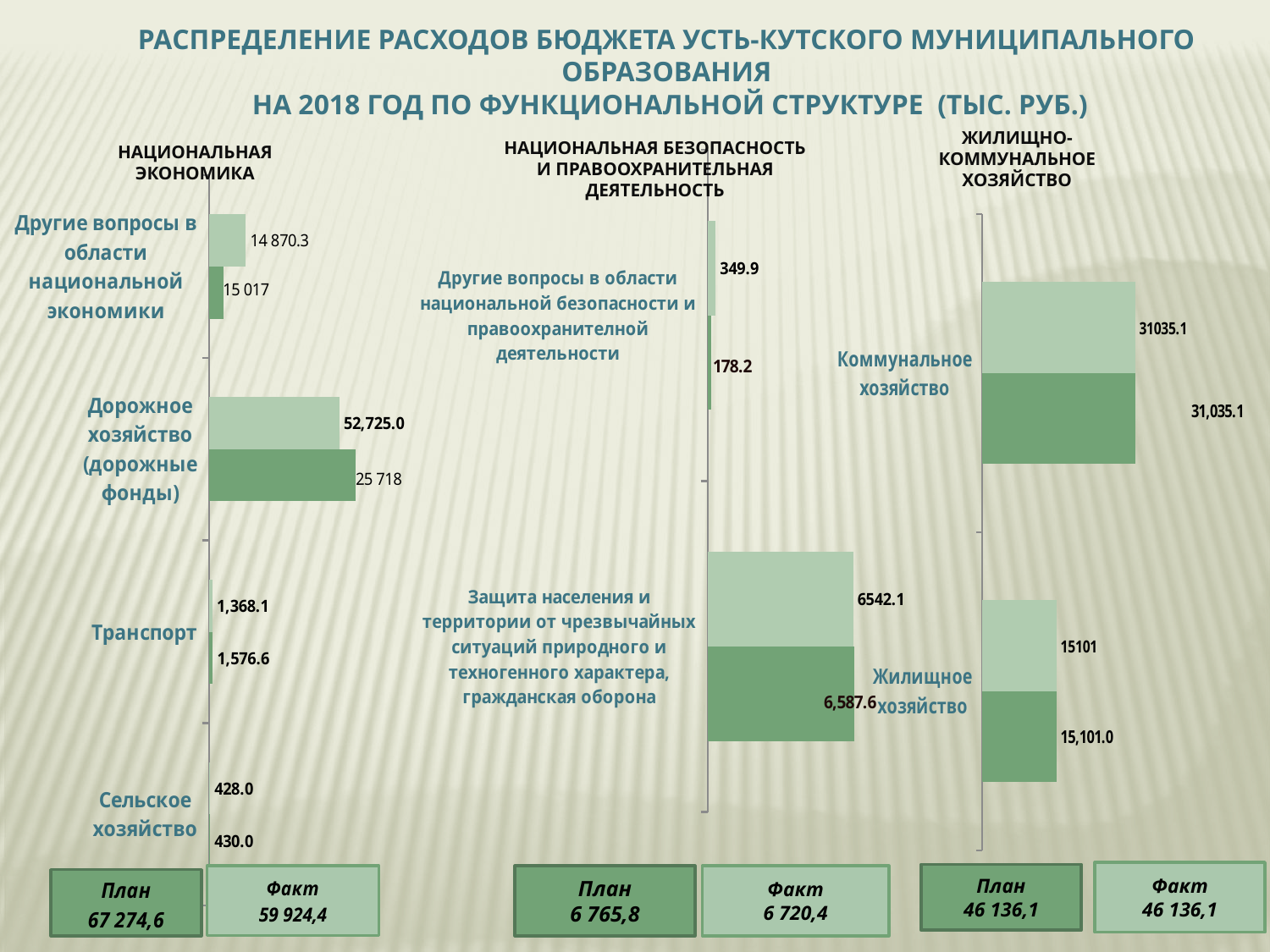
What kind of chart is used on the slide for the 'Национальная экономика' section? bar chart In the 'Национальная экономика' chart, what is the Факт value for 'Дорожное хозяйство (дорожные фонды)'? 52,725.0 In the 'Национальная экономика' chart, which category has the lowest План value? Сельское хозяйство In the 'Национальная экономика' chart, what is the План value for 'Дорожное хозяйство (дорожные фонды)'? 25 718 In the 'Жилищно-коммунальное хозяйство' chart, what is the План value for 'Жилищное хозяйство'? 15,101.0 In the 'Жилищно-коммунальное хозяйство' chart, which category has the larger Факт value, 'Коммунальное хозяйство' or 'Жилищное хозяйство'? Коммунальное хозяйство In the 'Национальная безопасность и правоохранительная деятельность' chart, what is the План value for 'Защита населения и территории от чрезвычайных ситуаций природного и техногенного характера, гражданская оборона'? 6,587.6 In the 'Жилищно-коммунальное хозяйство' chart, what is the Факт value for 'Коммунальное хозяйство'? 31035.1 In the 'Национальная экономика' chart, how many categories are shown? 4 In the 'Национальная экономика' chart, which category has the highest Факт value? Дорожное хозяйство (дорожные фонды) In the 'Национальная безопасность и правоохранительная деятельность' chart, what is the Факт value for 'Другие вопросы в области национальной безопасности и правоохранителной деятельности'? 349.9